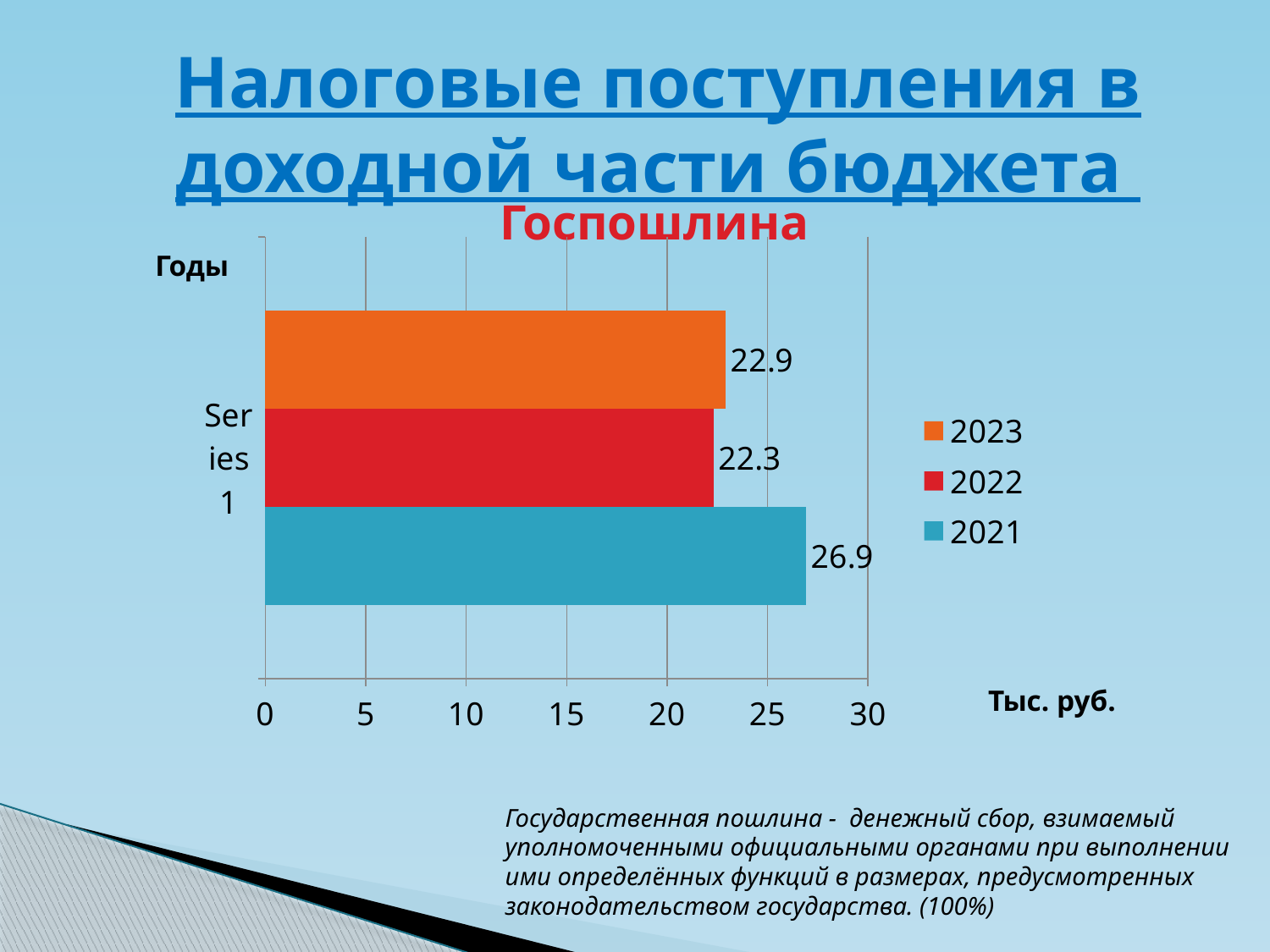
Which year has the highest value in the Госпошлина chart? 2021 Is the value for 2021 in the Госпошлина chart greater or less than 25? greater What is the value for 2022 in the Госпошлина chart? 22.3 Which is larger in the Госпошлина chart, the value for 2021 or the value for 2022? 2021 How many series does the legend of the Госпошлина chart list? 3 Which year has the lowest value in the Госпошлина chart? 2022 What is the value for 2021 in the Госпошлина chart? 26.9 What is the value for 2023 in the Госпошлина chart? 22.9 What is the difference between the 2021 and 2023 values in the Госпошлина chart? 4 What is the difference between the 2023 and 2022 values in the Госпошлина chart? 0.6 What unit label is shown next to the horizontal axis of the Госпошлина chart? Тыс. руб. What kind of chart is the Госпошлина chart? bar chart